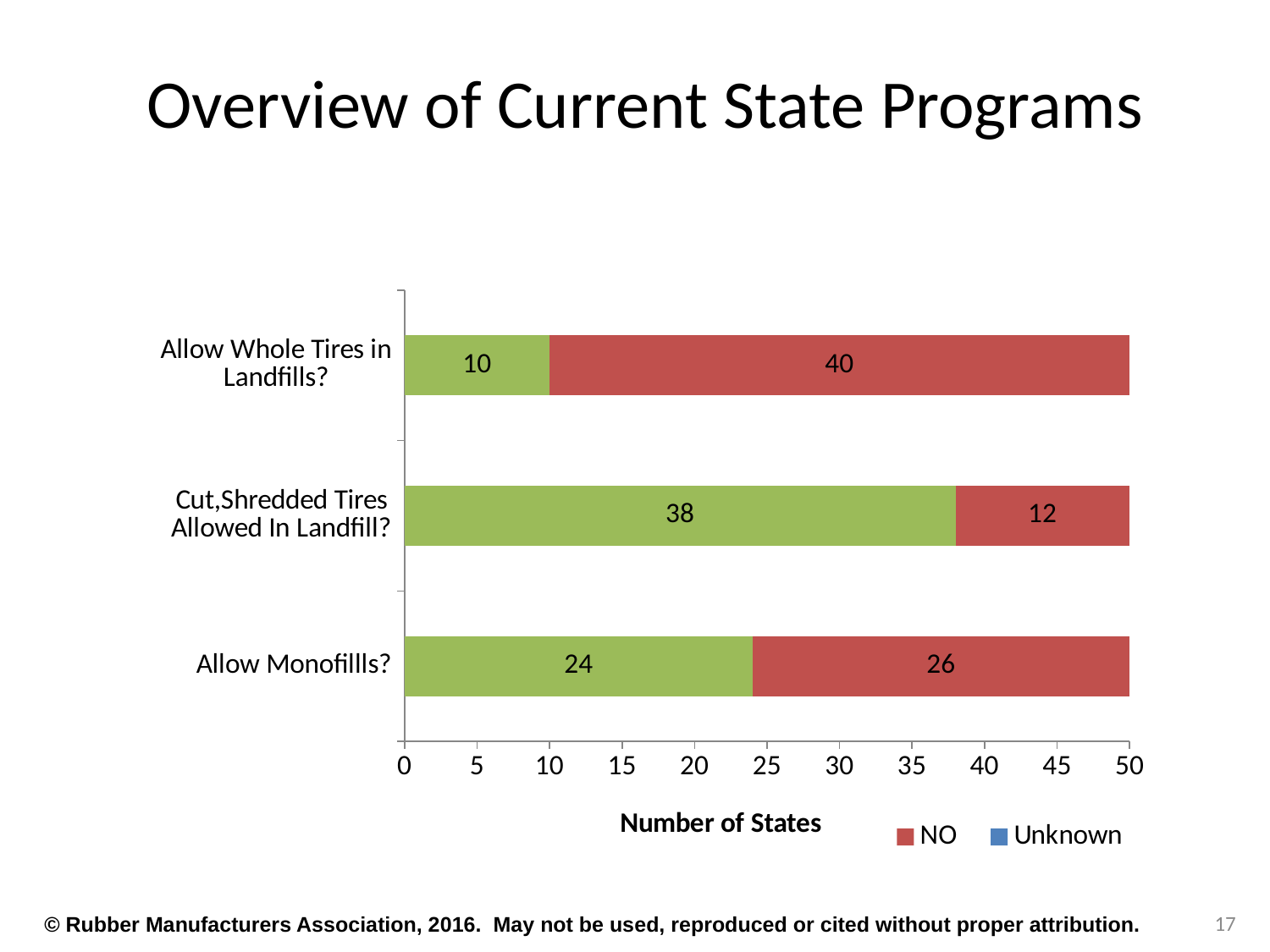
What kind of chart is shown on the slide? Stacked bar chart What is the total of the stacked bar for "Allow Monofillls?"? 50 How many series does the legend list? 2 What is the NO value for "Allow Monofillls?"? 26 What is the difference between the NO value for "Allow Whole Tires in Landfills?" and the NO value for "Cut,Shredded Tires Allowed In Landfill?"? 28 How many categories are shown on the chart? 3 Which category has the lowest NO value? Cut,Shredded Tires Allowed In Landfill? What is the value of the green segment for "Cut,Shredded Tires Allowed In Landfill?"? 38 Which has the larger green segment: "Allow Monofillls?" or "Allow Whole Tires in Landfills?"? Allow Monofillls? What is the NO value for "Allow Whole Tires in Landfills?"? 40 What is the title of the horizontal axis? Number of States Which category has the highest NO value? Allow Whole Tires in Landfills?